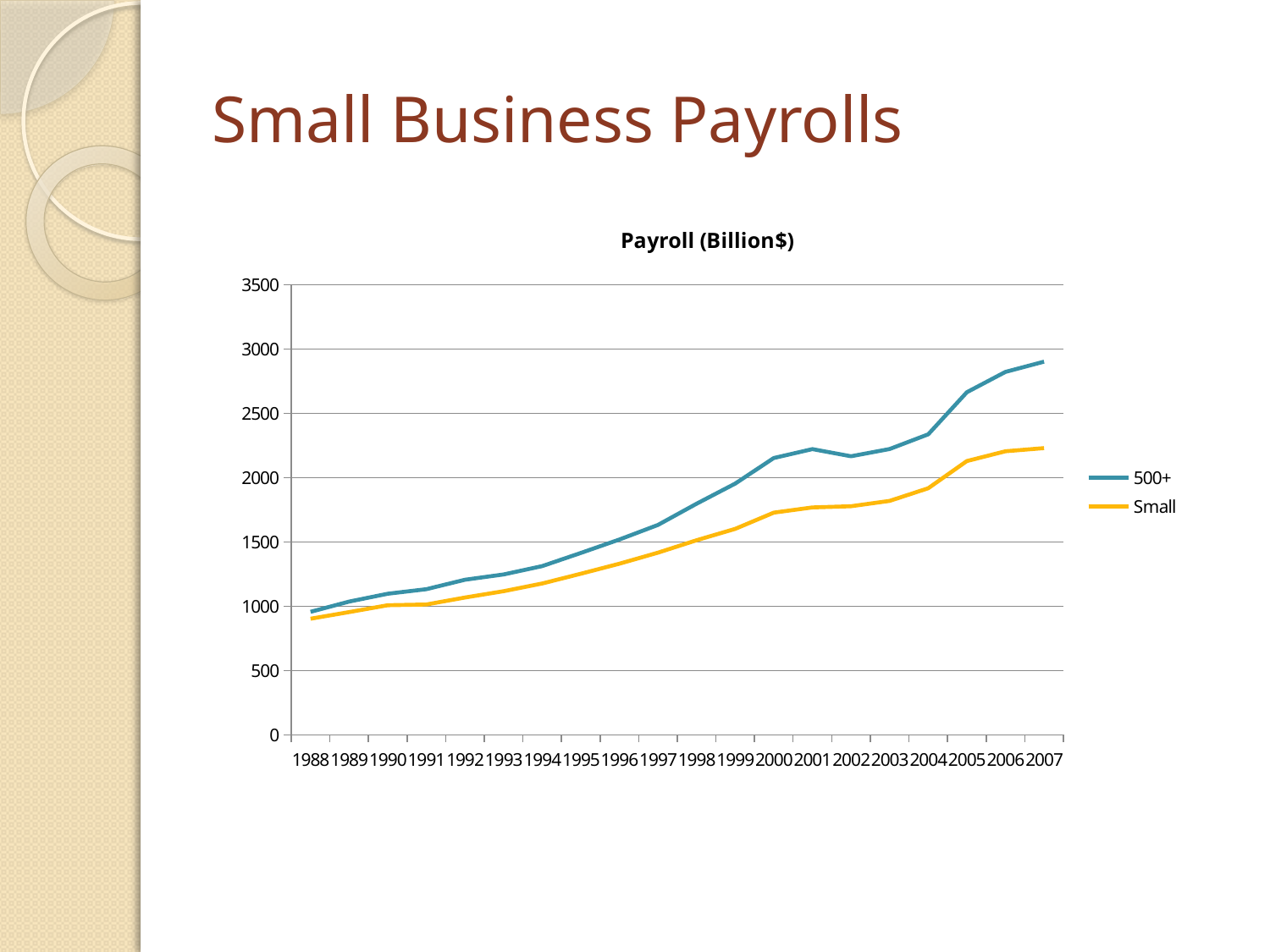
Is the value for Small in 1988 greater or less than 1000? less Is the value for Small in 2007 greater or less than 2500? less What kind of chart is shown on the slide? line chart How many series does the legend list? 2 Is the value for 500+ in 2007 greater or less than 2500? greater In 2007, which series has the larger value, 500+ or Small? 500+ Do the values for the 500+ series generally rise or fall from 1988 to 2007? rise In which year does the 500+ series reach its highest value? 2007 What is the title of the chart? Payroll (Billion$) Which series is drawn in yellow? Small How many years are plotted along the x axis? 20